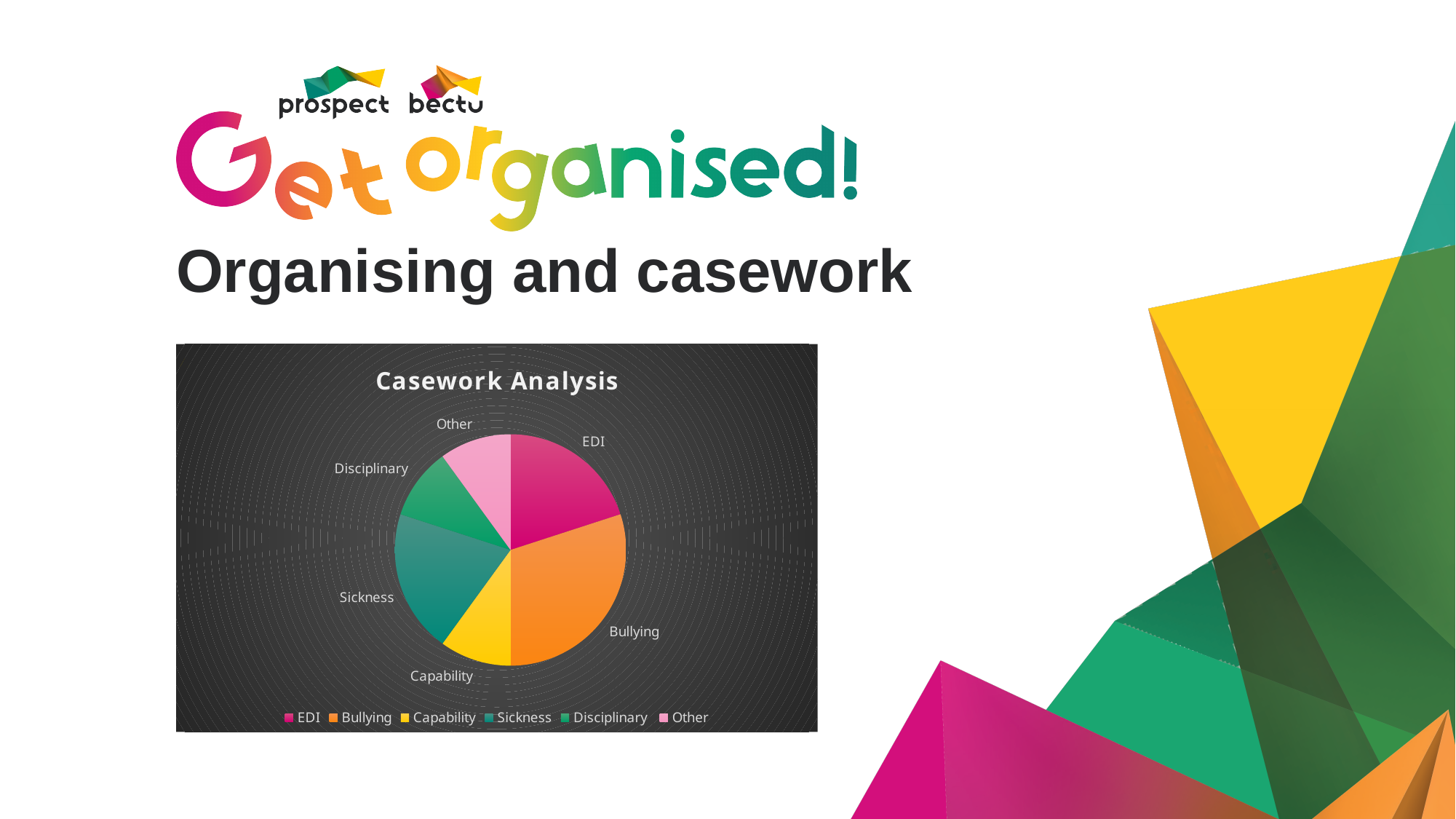
How many slices does the pie chart have? 6 What colour is the Bullying slice? orange What is the title of the chart? Casework Analysis What kind of chart is shown on the slide? pie chart Which slice is larger, Bullying or Capability? Bullying How many entries does the legend list? 6 Which slice is larger, Sickness or Capability? Sickness Which slice is larger, Bullying or EDI? Bullying Which category has the largest slice of the pie? Bullying